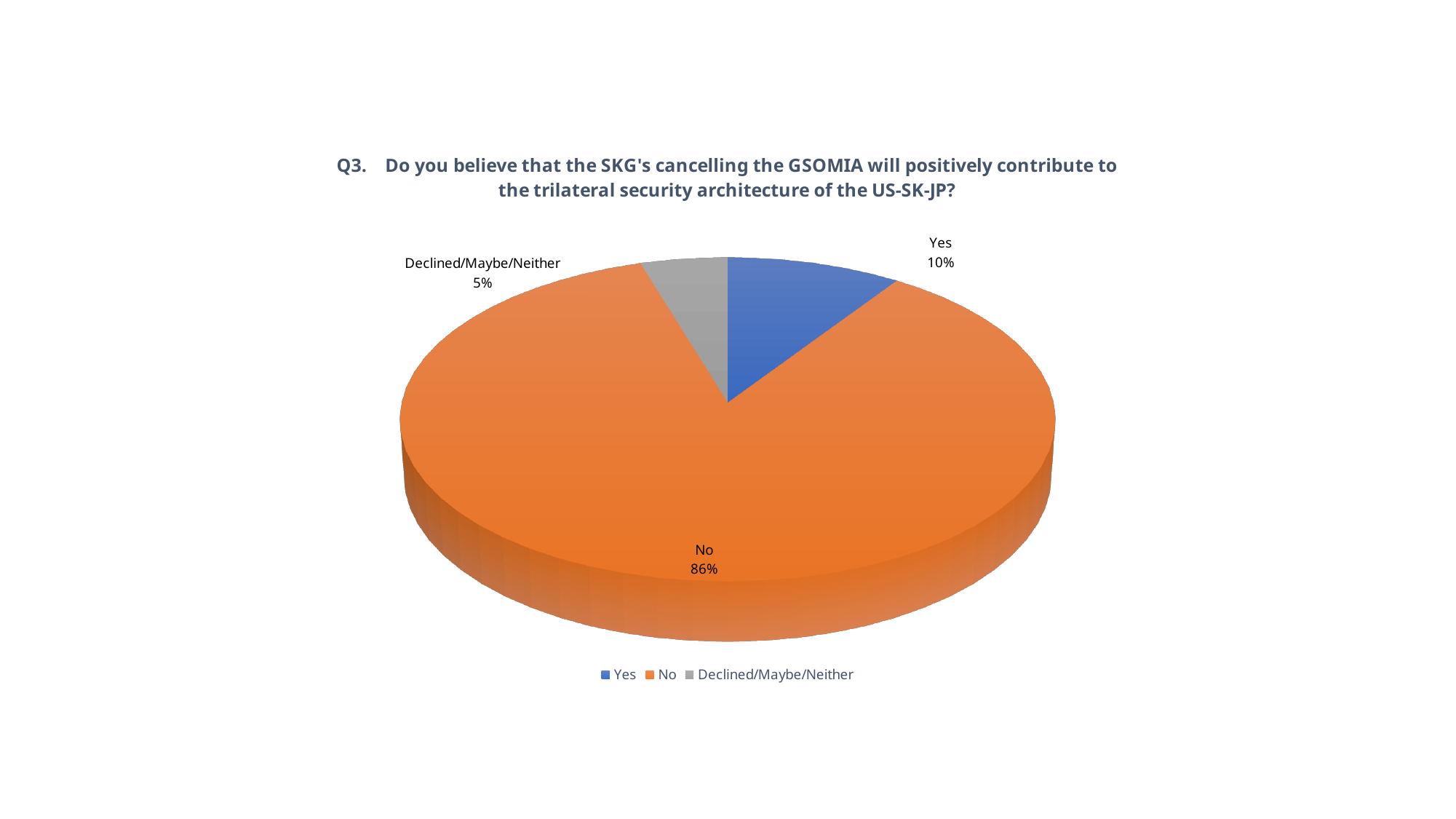
How many categories does the pie chart show? 3 What kind of chart is shown on the slide? Pie chart What percentage of respondents answered "Yes"? 10% Which response has the smallest share of the pie? Declined/Maybe/Neither What is the difference in percentage points between the "No" and "Yes" shares? 76 What percentage of respondents are in the "Declined/Maybe/Neither" category? 5% What colour is the "No" slice in the pie chart? Orange What share of the pie does the "No" slice represent? 86% How many entries does the legend list? 3 Which is larger, the "Yes" share or the "Declined/Maybe/Neither" share? Yes What percentage of respondents answered "No"? 86% Which response has the largest share of the pie? No